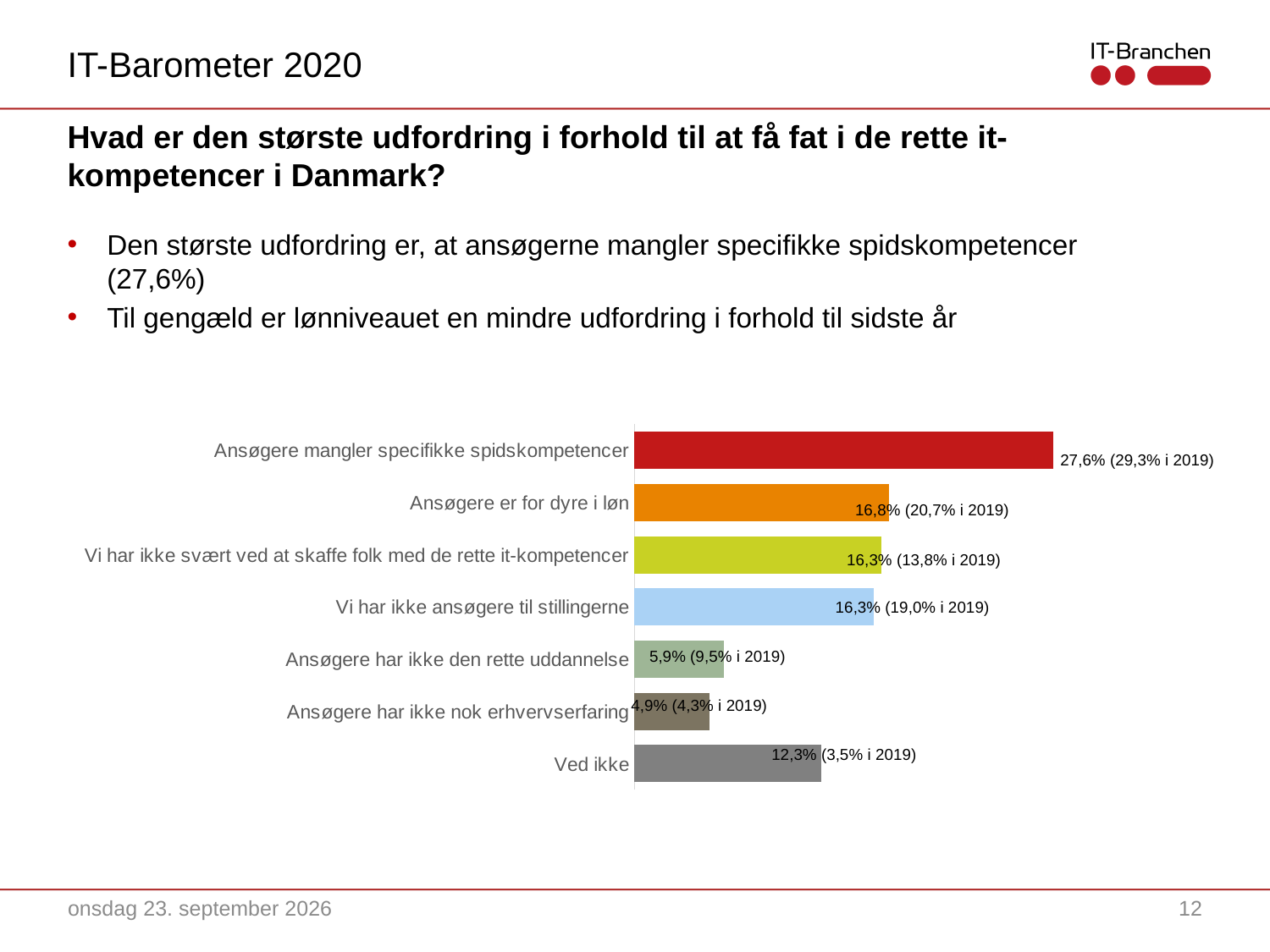
What is the 2020 value for "Ansøgere er for dyre i løn"? 16,8% What is the value for "Ansøgere mangler specifikke spidskompetencer" in 2020? 27,6% What type of chart is shown on the slide? Bar chart What is the difference between the 2020 values for "Ansøgere mangler specifikke spidskompetencer" and "Ansøgere er for dyre i løn"? 10,8 percentage points Which is larger in 2020: "Ved ikke" or "Ansøgere har ikke den rette uddannelse"? Ved ikke What colour is the bar for "Ansøgere mangler specifikke spidskompetencer"? Red What was the 2019 value for "Ved ikke" according to the data label? 3,5% What is the 2020 value for "Ansøgere har ikke nok erhvervserfaring"? 4,9% By how much did the value for "Ansøgere er for dyre i løn" change from 2019 (20,7%) to 2020 (16,8%)? 3,9 percentage points lower Which category has the highest 2020 value? Ansøgere mangler specifikke spidskompetencer Which category has the lowest 2020 value? Ansøgere har ikke nok erhvervserfaring How many categories are shown in the bar chart? 7